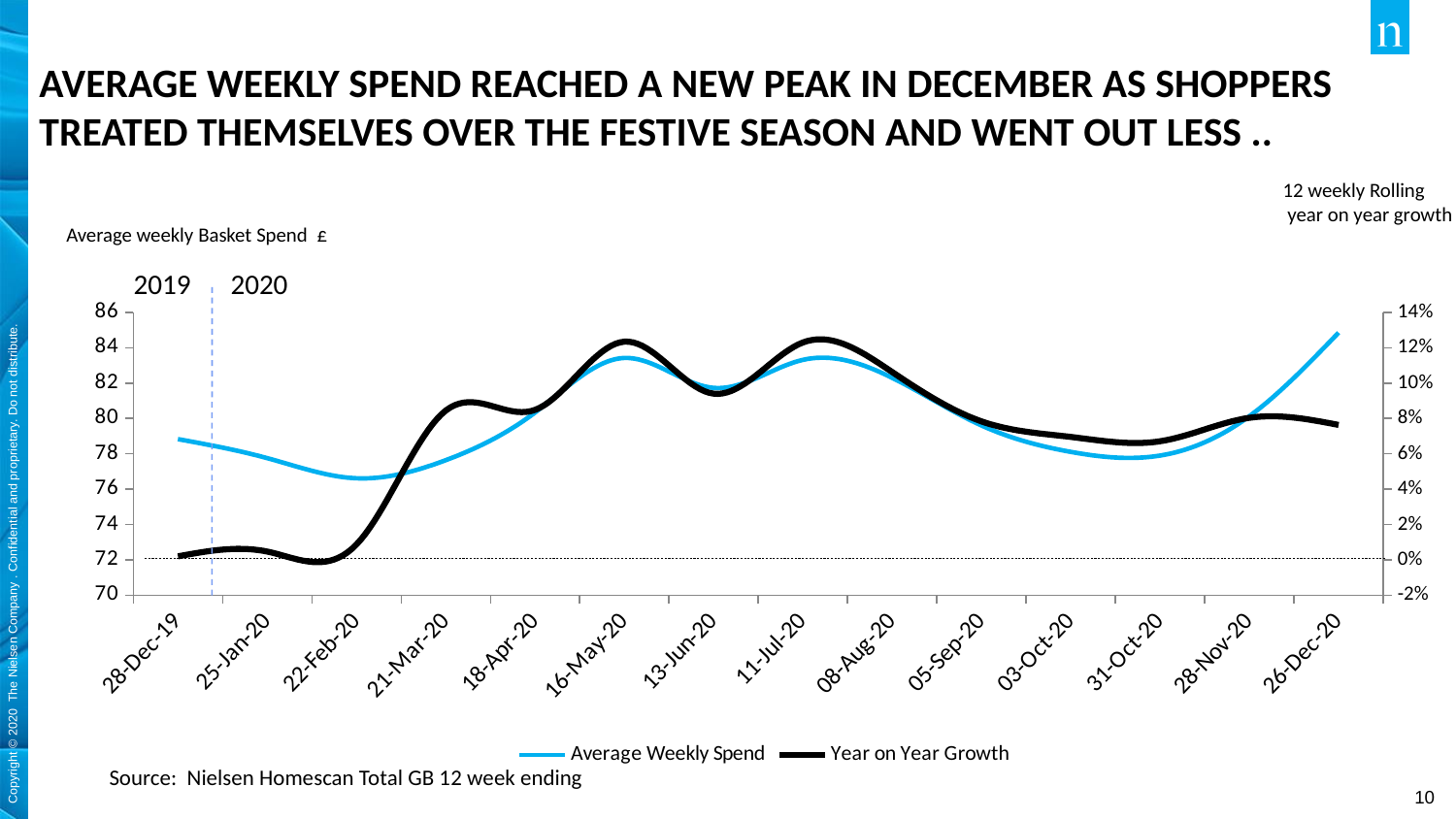
At which date does the Average Weekly Spend line reach its highest point? 26-Dec-20 Is the Year on Year Growth value at 28-Dec-19 greater or less than 2%? less Is the Average Weekly Spend value at 26-Dec-20 greater or less than 82? greater Does the Average Weekly Spend line rise or fall between 31-Oct-20 and 26-Dec-20? Rise How many series does the legend list? 2 Does the Average Weekly Spend line rise or fall between 28-Dec-19 and 22-Feb-20? Fall What kind of chart is shown on the slide? Line chart What are the two series named in the legend? Average Weekly Spend and Year on Year Growth How many date labels are shown along the x axis? 14 Is the Average Weekly Spend value at 22-Feb-20 greater or less than 78? less Which is larger, the Average Weekly Spend at 16-May-20 or at 05-Sep-20? 16-May-20